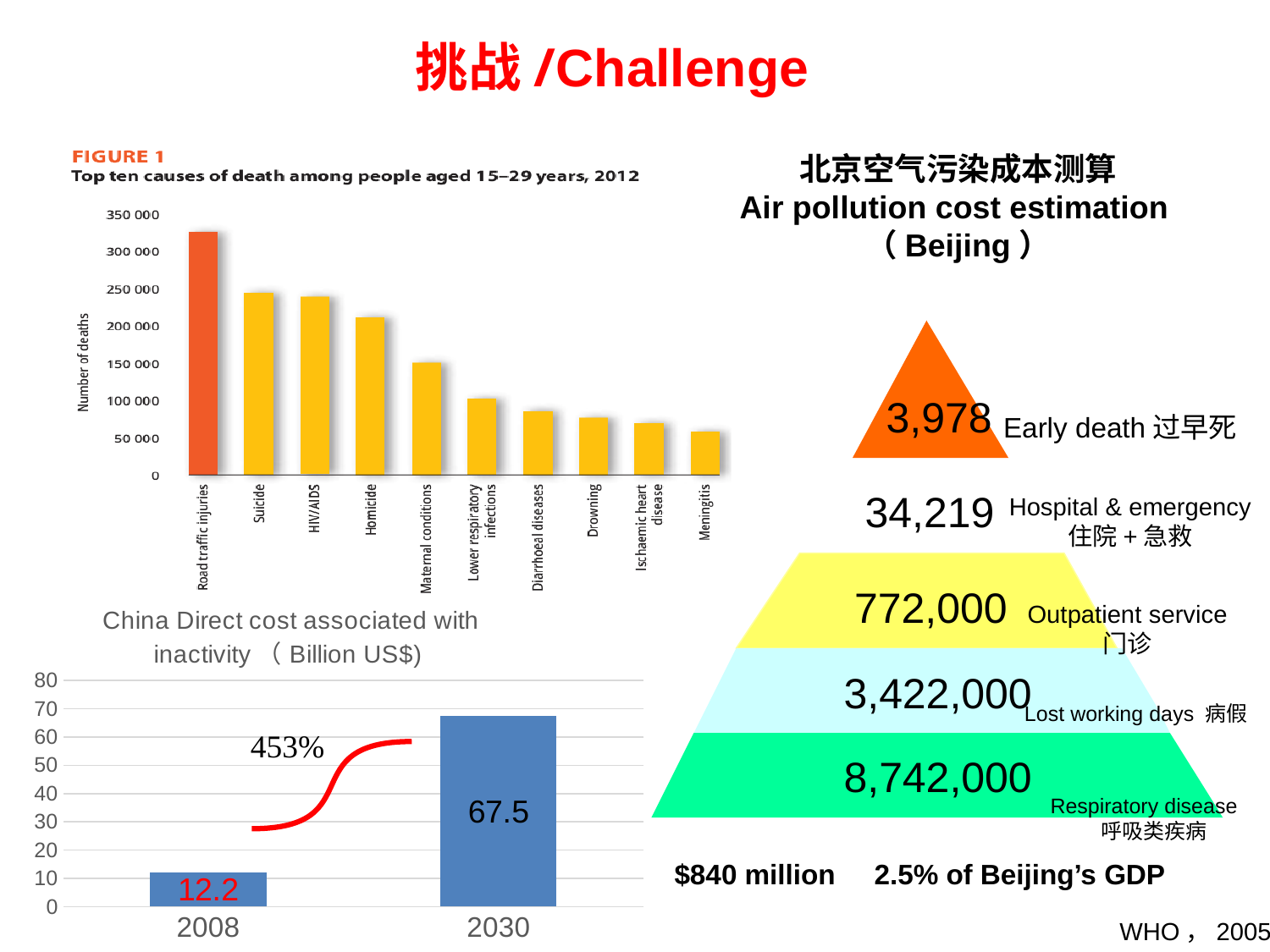
In the chart 'Top ten causes of death among people aged 15–29 years, 2012', is the value for Road traffic injuries greater or less than 300 000? greater In the chart 'China Direct cost associated with inactivity (Billion US$)', what percentage is written next to the red arrow between the two bars? 453% In the chart 'Top ten causes of death among people aged 15–29 years, 2012', which has more deaths, Suicide or Homicide? Suicide In the chart 'Top ten causes of death among people aged 15–29 years, 2012', which cause of death has the highest number of deaths? Road traffic injuries In the chart 'Top ten causes of death among people aged 15–29 years, 2012', is the value for Drowning greater or less than 100 000? less In the chart 'China Direct cost associated with inactivity (Billion US$)', what is the value for 2030? 67.5 In the chart 'China Direct cost associated with inactivity (Billion US$)', what is the value for 2008? 12.2 In the chart 'China Direct cost associated with inactivity (Billion US$)', do the values rise or fall from 2008 to 2030? rise In the chart 'Top ten causes of death among people aged 15–29 years, 2012', which cause of death has the lowest number of deaths? Meningitis How many causes of death are shown in the chart 'Top ten causes of death among people aged 15–29 years, 2012'? 10 What kind of chart is 'Top ten causes of death among people aged 15–29 years, 2012'? bar chart In the chart 'China Direct cost associated with inactivity (Billion US$)', what is the difference between the 2030 and 2008 values? 55.3